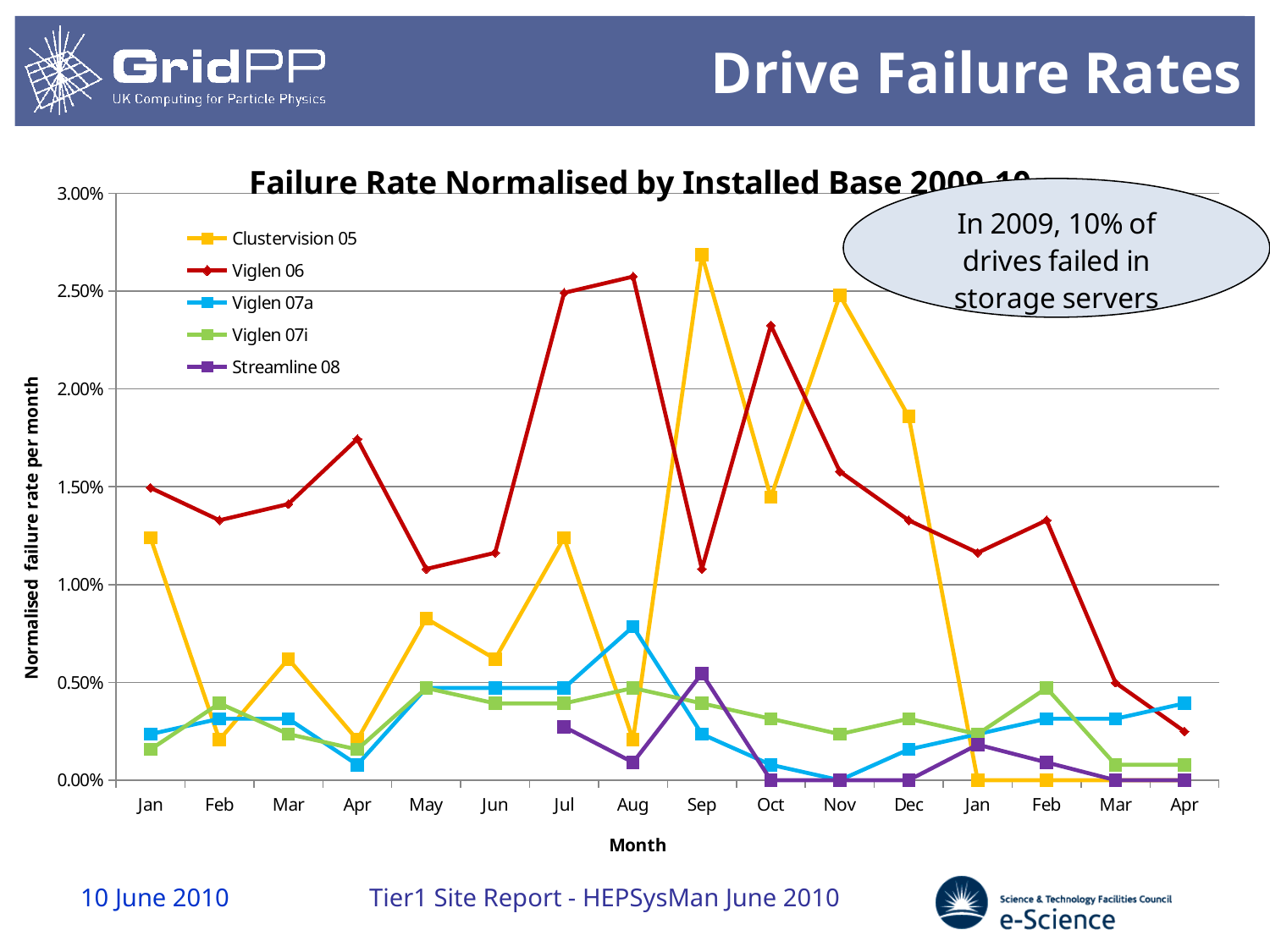
How many months are plotted along the x axis? 16 How many series does the legend list? 5 In which month does Clustervision 05 reach its highest value? Sep Is the value for Viglen 06 in May greater or less than 1.50%? less Which is larger in Jul, the value for Viglen 06 or the value for Clustervision 05? Viglen 06 Which series has the highest value in Jul? Viglen 06 Does the Clustervision 05 line rise or fall from Dec to the following Jan? fall Is the value for Clustervision 05 in Sep greater or less than 2.50%? greater Is the value for Streamline 08 in Sep greater or less than 1.00%? less What kind of chart is shown on the slide? line chart What is the label on the y axis? Normalised failure rate per month